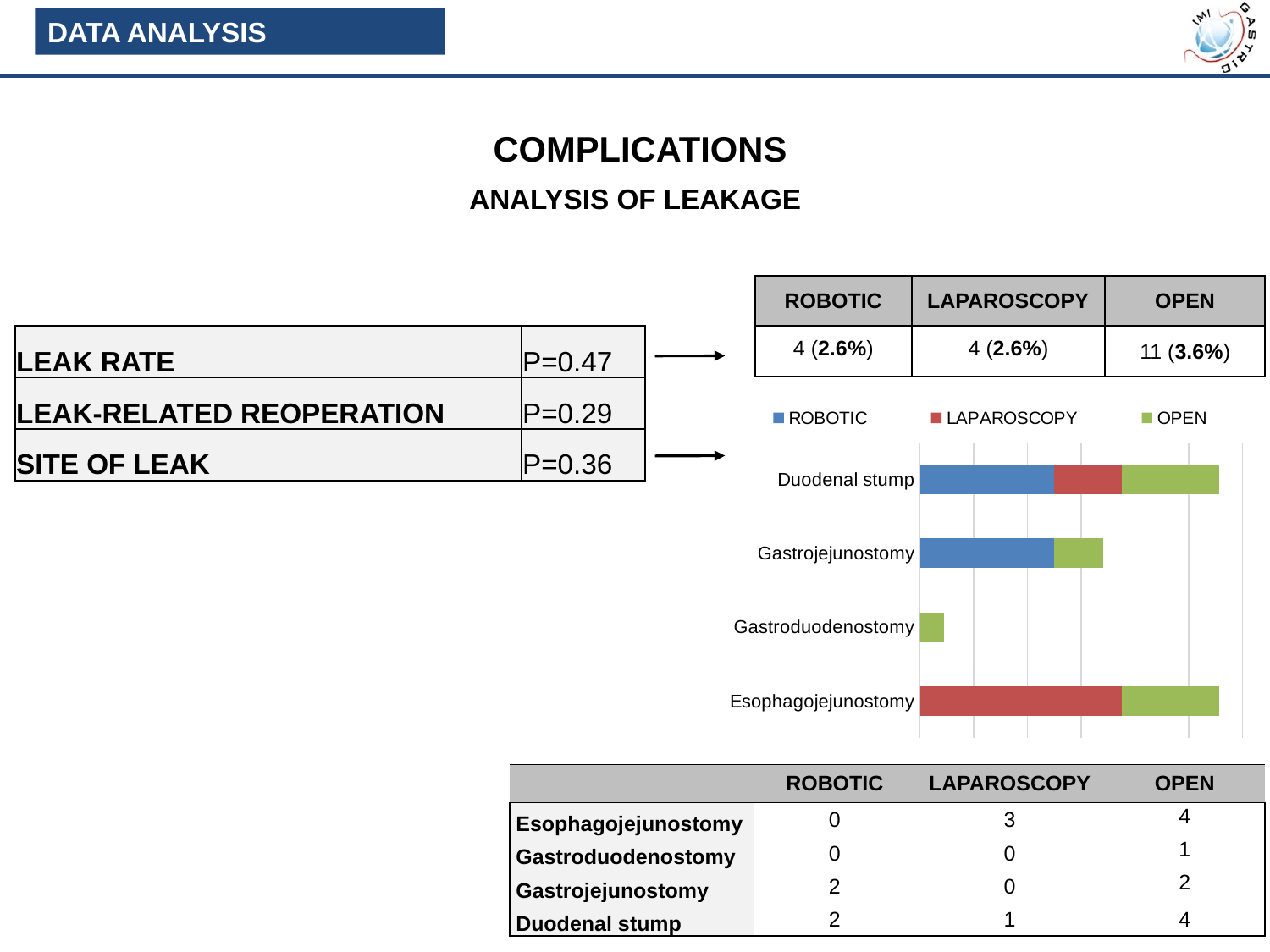
Which is larger, the OPEN value for Duodenal stump or the OPEN value for Gastrojejunostomy? Duodenal stump Which leak site has the shortest stacked bar? Gastroduodenostomy How many series does the chart's legend list? 3 Which leak site has the highest LAPAROSCOPY value? Esophagojejunostomy What is the ROBOTIC value for Gastrojejunostomy? 2 How many leak-site categories are plotted in the chart? 4 What is the LAPAROSCOPY value for Duodenal stump? 1 What is the difference between the LAPAROSCOPY values for Esophagojejunostomy and Duodenal stump? 2 What kind of chart is shown on the slide? bar chart What is the OPEN value for Esophagojejunostomy? 4